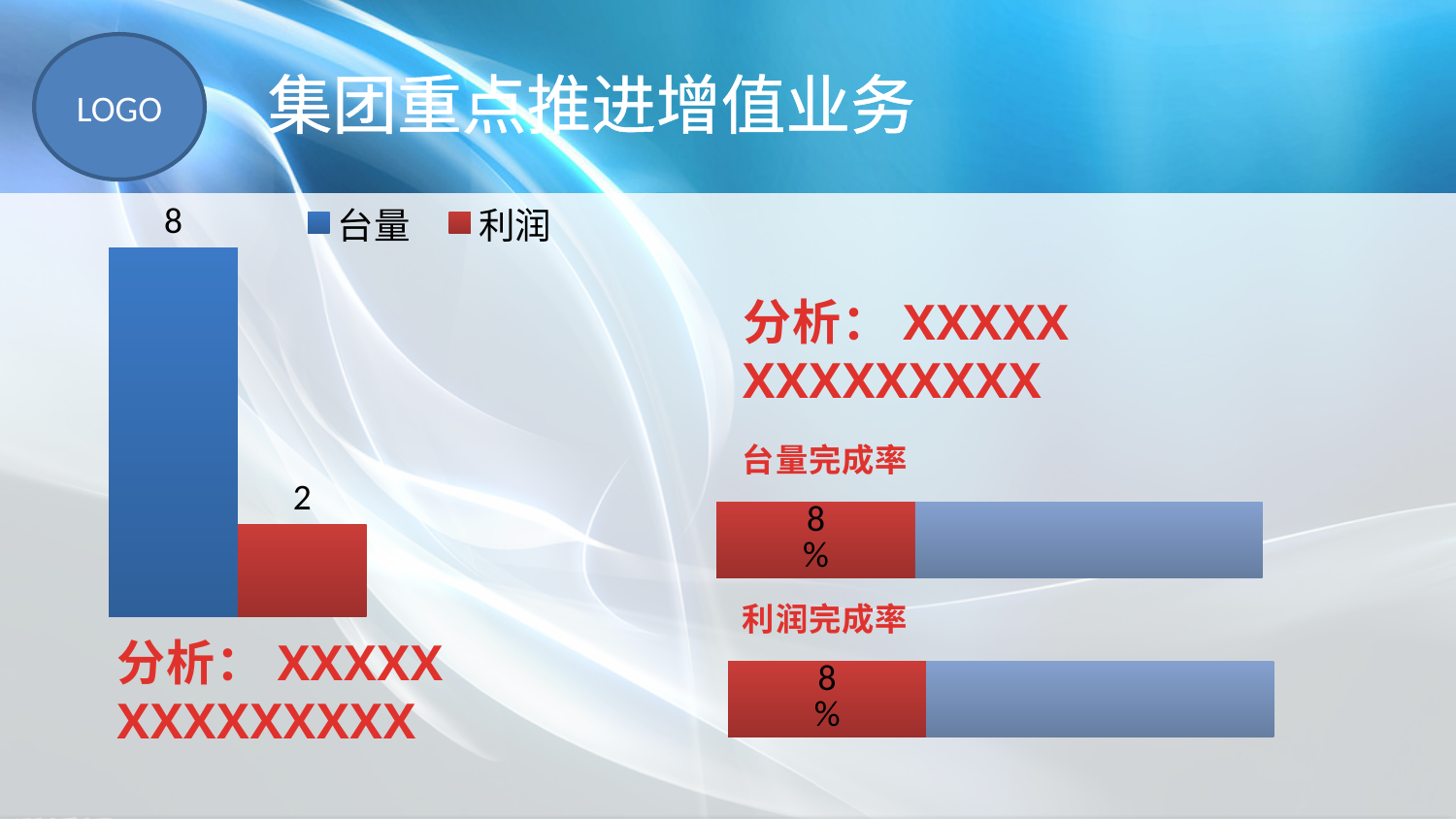
How many bars are plotted in the bar chart on the left? 2 What type of chart is shown on the left of the slide? bar chart What percentage is shown on the 台量完成率 progress bar on the right? 8% In the bar chart on the left, what colour is the 利润 bar? red In the bar chart on the left, which series has the lower value? 利润 What percentage is shown on the 利润完成率 progress bar on the right? 8% In the bar chart on the left, what is the difference between the 台量 value and the 利润 value? 6 In the bar chart on the left, what is the value for 台量? 8 In the bar chart on the left, what is the value for 利润? 2 In the bar chart on the left, is the value for 台量 larger or smaller than the value for 利润? larger In the bar chart on the left, which series has the higher value? 台量 How many series does the legend of the bar chart on the left list? 2